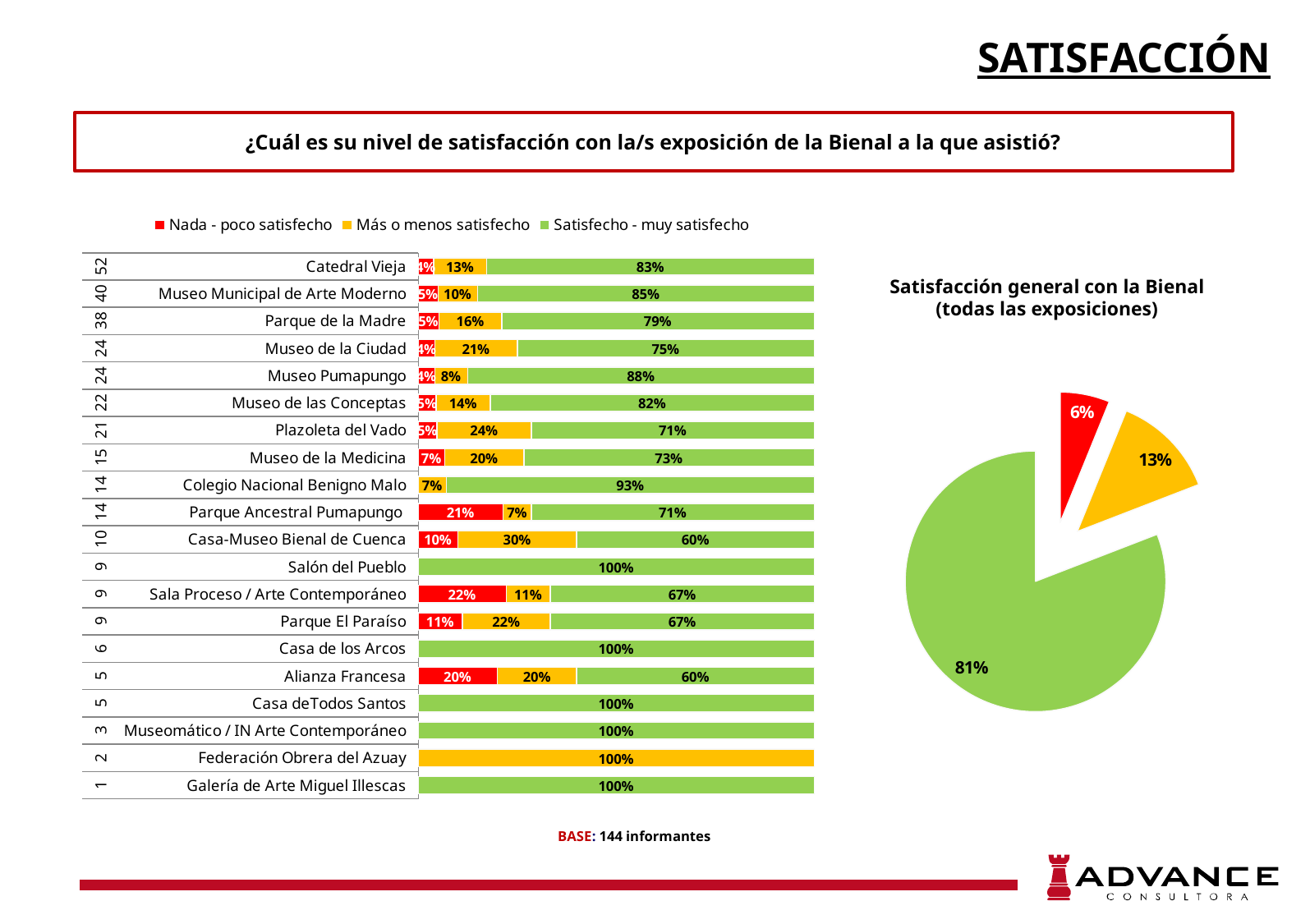
In the pie chart 'Satisfacción general con la Bienal', what share does the 'Nada - poco satisfecho' slice have? 6% In the bar chart on the left, how many exhibition venues (categories) are shown? 20 In the bar chart on the left, which has the larger 'Más o menos satisfecho' value: Plazoleta del Vado or Museo de la Medicina? Plazoleta del Vado What kind of chart is the chart on the left of the slide? bar chart In the bar chart on the left, what is the 'Satisfecho - muy satisfecho' value for Catedral Vieja? 83% In the bar chart on the left, what is the 'Más o menos satisfecho' value for Casa-Museo Bienal de Cuenca? 30% In the bar chart on the left, how many series does the legend list? 3 In the bar chart on the left, what is the 'Nada - poco satisfecho' value for Sala Proceso / Arte Contemporáneo? 22% In the bar chart on the left, which venue has 100% in the 'Más o menos satisfecho' series? Federación Obrera del Azuay What kind of chart is the chart titled 'Satisfacción general con la Bienal (todas las exposiciones)'? pie chart In the bar chart on the left, what is the difference between the 'Satisfecho - muy satisfecho' values for Museo Pumapungo and Museo de la Ciudad? 13 percentage points In the pie chart 'Satisfacción general con la Bienal', which category has the largest slice? Satisfecho - muy satisfecho (81%)